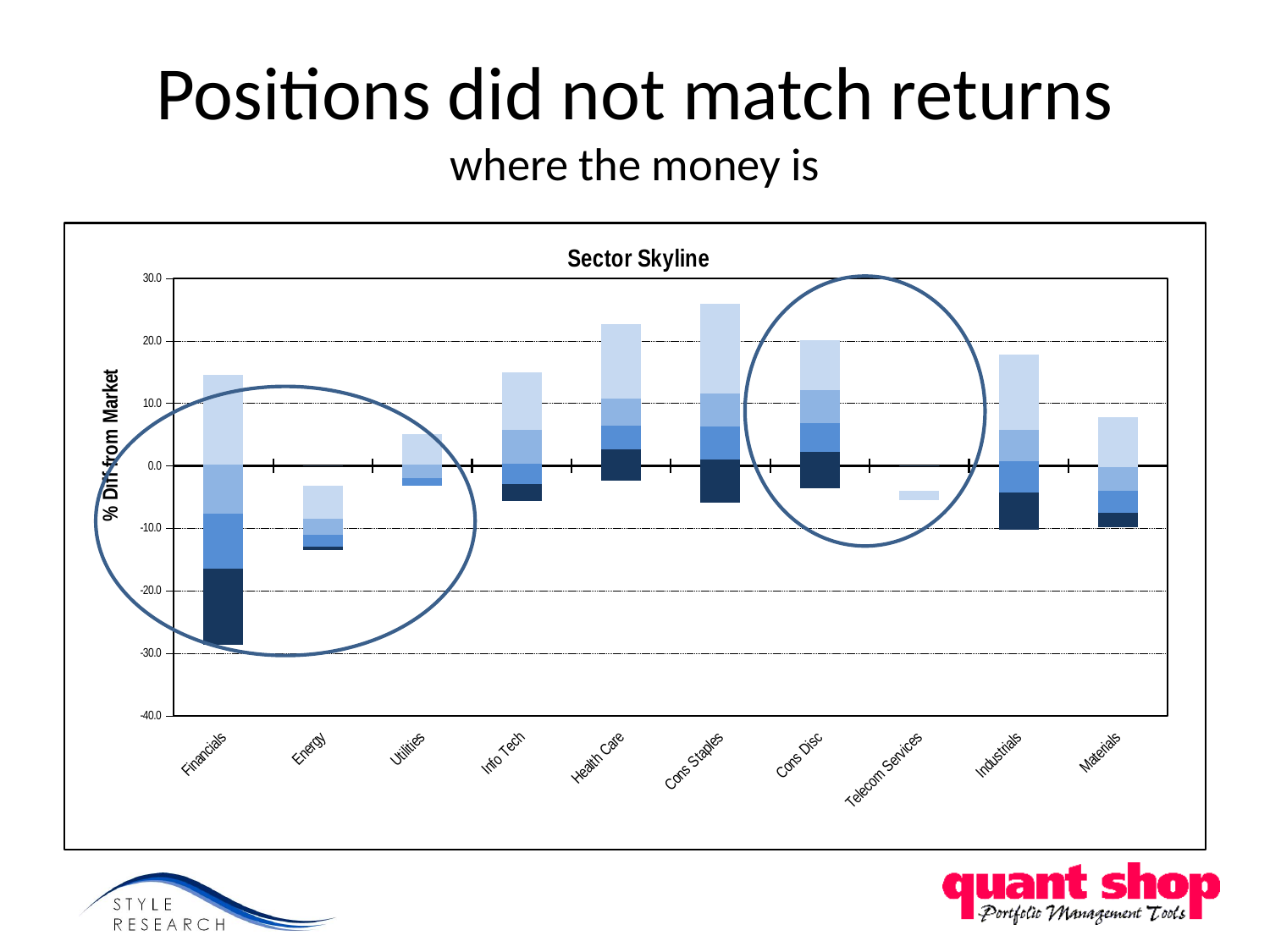
What is the label on the vertical axis of the Sector Skyline chart? % Diff from Market Is the top of the Materials bar greater or less than 10.0? less What kind of chart is the Sector Skyline chart? stacked bar chart Is the lowest point of the Energy bar greater or less than -10.0? less Is the top of the Cons Staples bar greater or less than 20.0? greater Which sector's stacked bar reaches the highest point above zero in the Sector Skyline chart? Cons Staples How many sectors are shown on the x axis of the Sector Skyline chart? 10 Which sector's stacked bar extends furthest below zero in the Sector Skyline chart? Financials What is the title of the chart on the slide? Sector Skyline